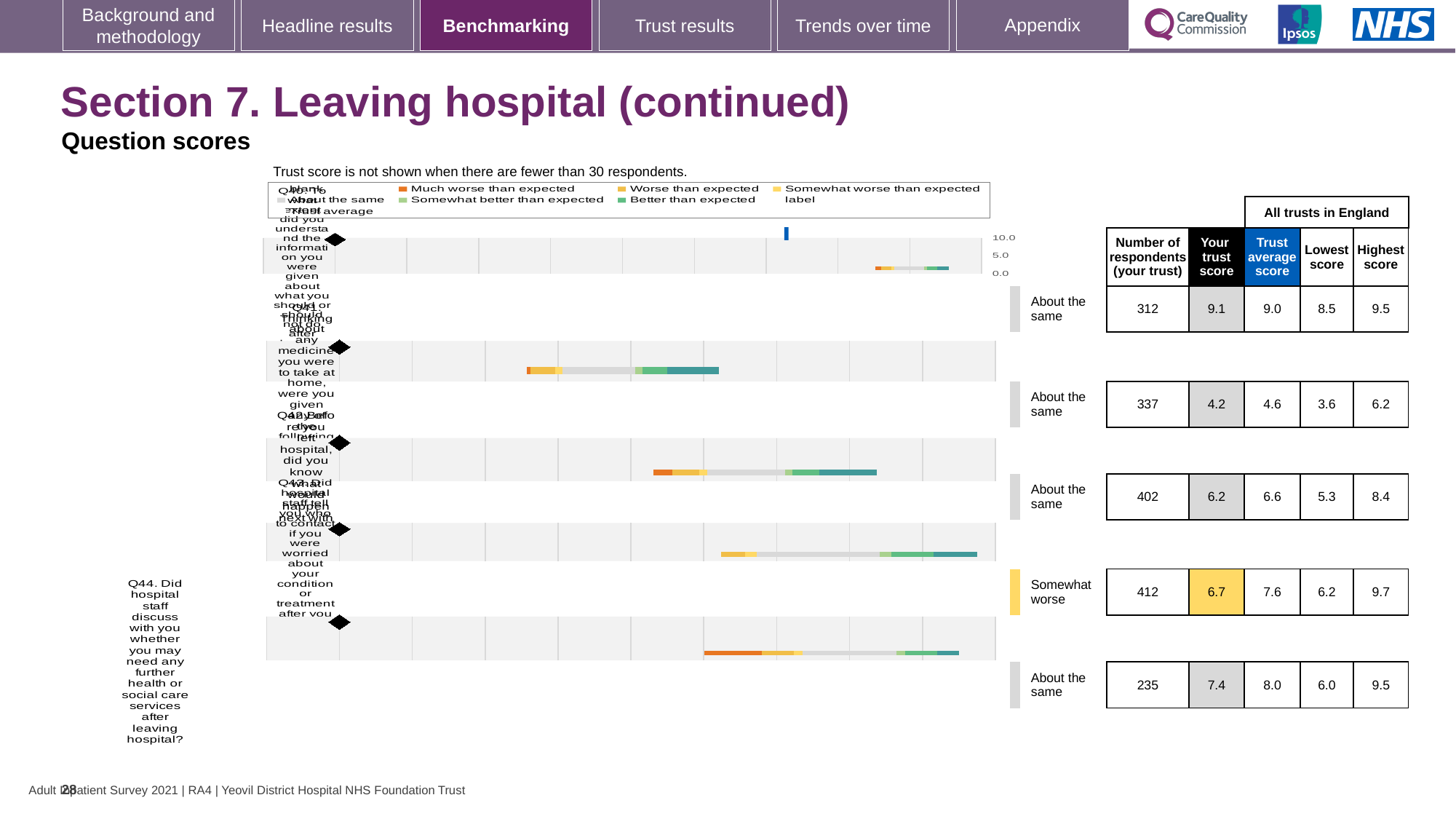
What is the trust score for Q44 (the row with 235 respondents)? 7.4 How many question rows are plotted in the chart? 5 What kind of chart is used to show the question scores on this slide? bar chart Which row has the highest 'Your trust score', and what is it? The row with 312 respondents, 9.1 What is the difference between the highest score and the lowest score for Q44 (the row with 235 respondents)? 3.5 How many respondents from the trust answered Q44? 235 What is the lowest 'Your trust score' shown in the table? 4.2 Is the trust score for Q44 (the row with 235 respondents) greater or less than 5.0? greater Which benchmark category is assigned to the row with 412 respondents? Somewhat worse What is the trust average score for Q44 (the row with 235 respondents)? 8.0 What colour is used for the 'Somewhat worse than expected' category in the legend? yellow For the row with 412 respondents, is the trust score higher or lower than the trust average? lower